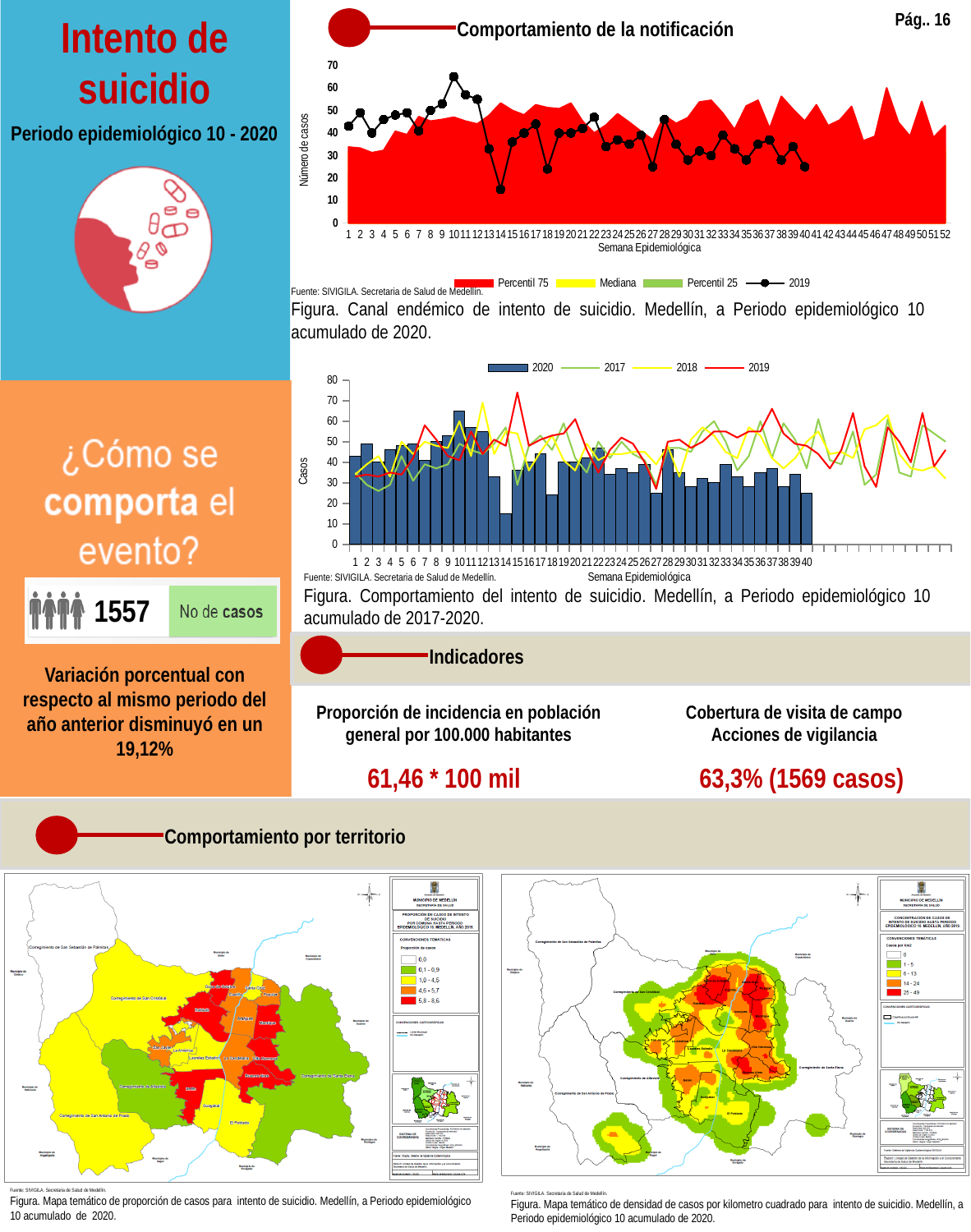
In the bottom chart 'Comportamiento del intento de suicidio', how many series does the legend list? 4 In the top chart 'Canal endémico de intento de suicidio', at which epidemiological week does the 2019 line reach its lowest value? 14 In the bottom chart 'Comportamiento del intento de suicidio', at which epidemiological week is the 2020 bar the shortest? 14 In the top chart 'Canal endémico de intento de suicidio', what is the label of the y axis? Número de casos In the top chart 'Canal endémico de intento de suicidio', is the 2019 value at week 10 greater or less than 60? greater In the top chart 'Canal endémico de intento de suicidio', is the 2019 value at week 14 greater or less than 20? less In the top chart 'Canal endémico de intento de suicidio', which is larger for 2019: the value at week 10 or the value at week 14? week 10 In the top chart 'Canal endémico de intento de suicidio', at which epidemiological week does the 2019 line reach its highest value? 10 In the top chart 'Canal endémico de intento de suicidio', how many entries does the legend list? 4 In the bottom chart 'Comportamiento del intento de suicidio', at which epidemiological week is the 2020 bar the tallest? 10 In the bottom chart 'Comportamiento del intento de suicidio', is the 2020 value at week 14 greater or less than 20? less In the bottom chart 'Comportamiento del intento de suicidio', which year is plotted as bars? 2020